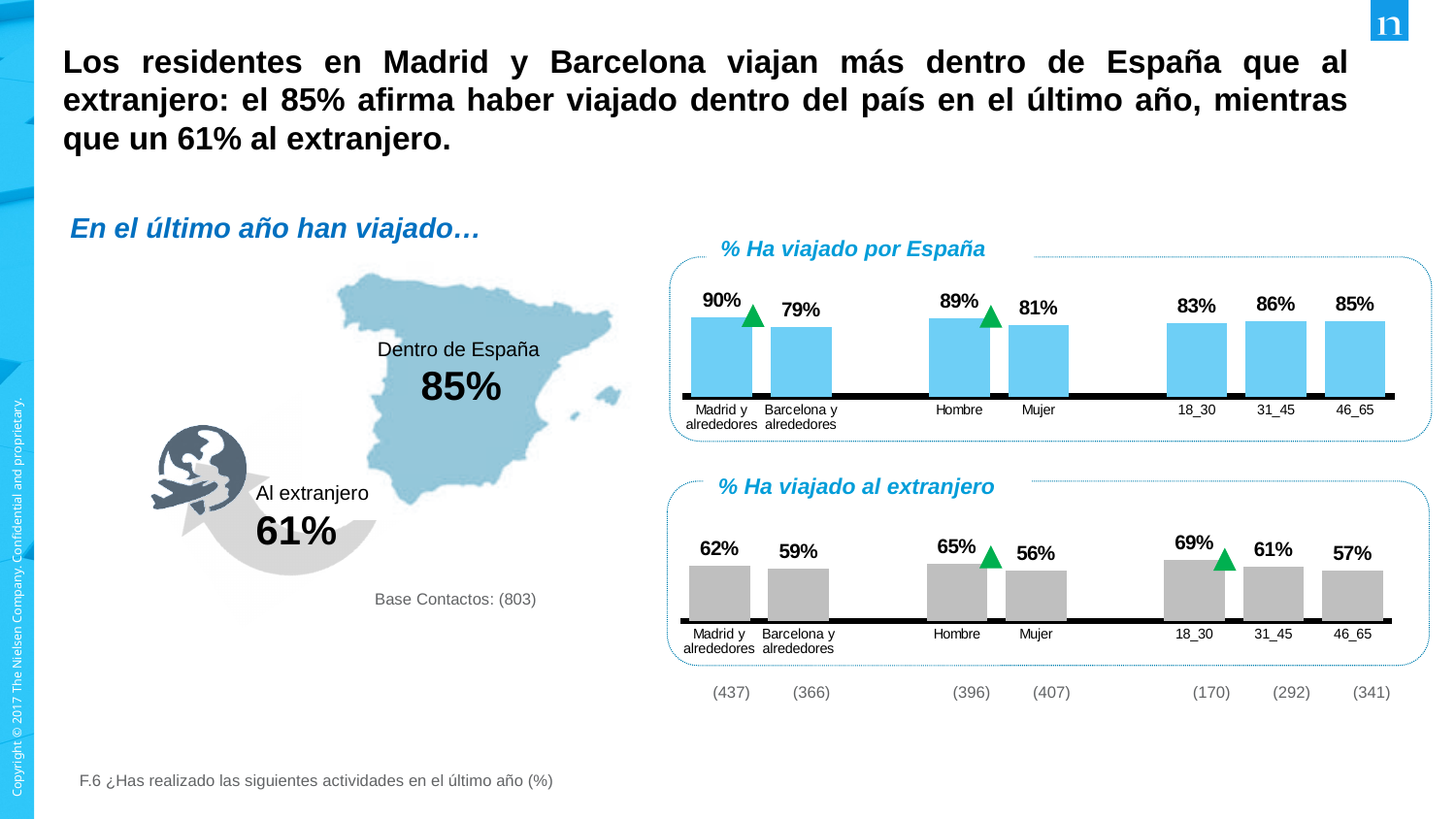
In the '% Ha viajado al extranjero' chart, what is the difference between Hombre and Mujer? 9% What colour are the bars in the '% Ha viajado por España' chart? Light blue What type of chart is the '% Ha viajado al extranjero' chart? Bar chart In the '% Ha viajado por España' chart, what is the value for 31_45? 86% In the '% Ha viajado por España' chart, what is the value for Hombre? 89% In the '% Ha viajado al extranjero' chart, what is the value for 18_30? 69% In the '% Ha viajado al extranjero' chart, what is the value for Barcelona y alrededores? 59% In the '% Ha viajado por España' chart, which category has the highest value? Madrid y alrededores In the '% Ha viajado al extranjero' chart, which category has the lowest value? Mujer In the '% Ha viajado por España' chart, what is the difference between Madrid y alrededores and Barcelona y alrededores? 11% How many categories are shown in the '% Ha viajado por España' chart? 7 In the '% Ha viajado al extranjero' chart, which is larger, the value for 31_45 or 46_65? 31_45